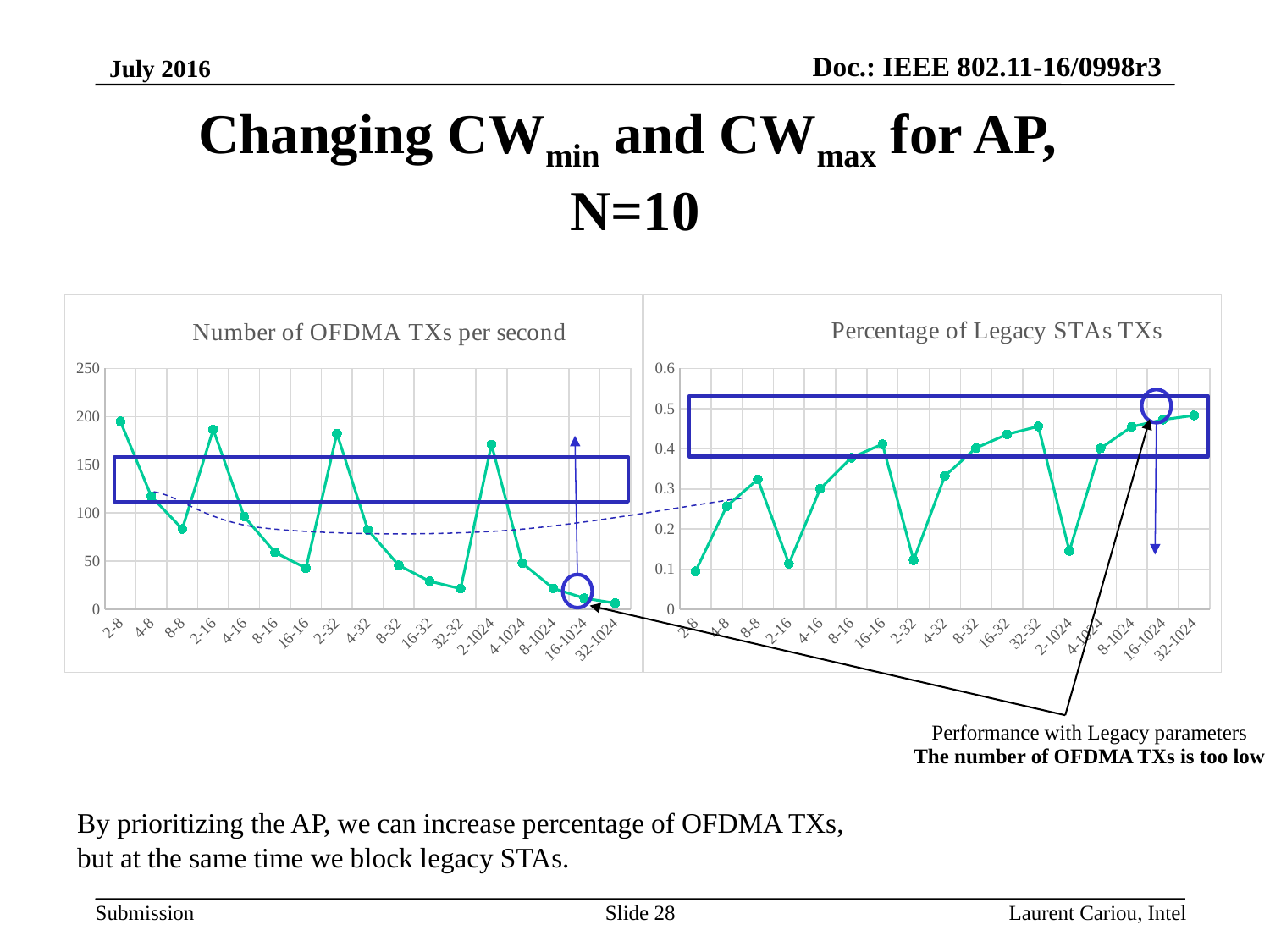
In the left chart, "Number of OFDMA TXs per second", do the values overall rise or fall from left to right along the x axis? fall In the right chart, "Percentage of Legacy STAs TXs", which is larger, the value for 16-16 or the value for 2-32? 16-16 In the right chart, "Percentage of Legacy STAs TXs", which category has the lowest value? 2-8 In the right chart, "Percentage of Legacy STAs TXs", is the value for 2-32 greater or less than 0.2? less In the left chart, "Number of OFDMA TXs per second", which category has the highest value? 2-8 In the right chart, "Percentage of Legacy STAs TXs", is the value for 32-32 greater or less than 0.4? greater What type of chart is the left chart titled "Number of OFDMA TXs per second"? line chart In the left chart, "Number of OFDMA TXs per second", is the value for 2-8 greater or less than 150? greater What is the title of the right chart on the slide? Percentage of Legacy STAs TXs In the left chart, "Number of OFDMA TXs per second", which is larger, the value for 2-8 or the value for 8-8? 2-8 How many categories are plotted along the x axis of the left chart, "Number of OFDMA TXs per second"? 17